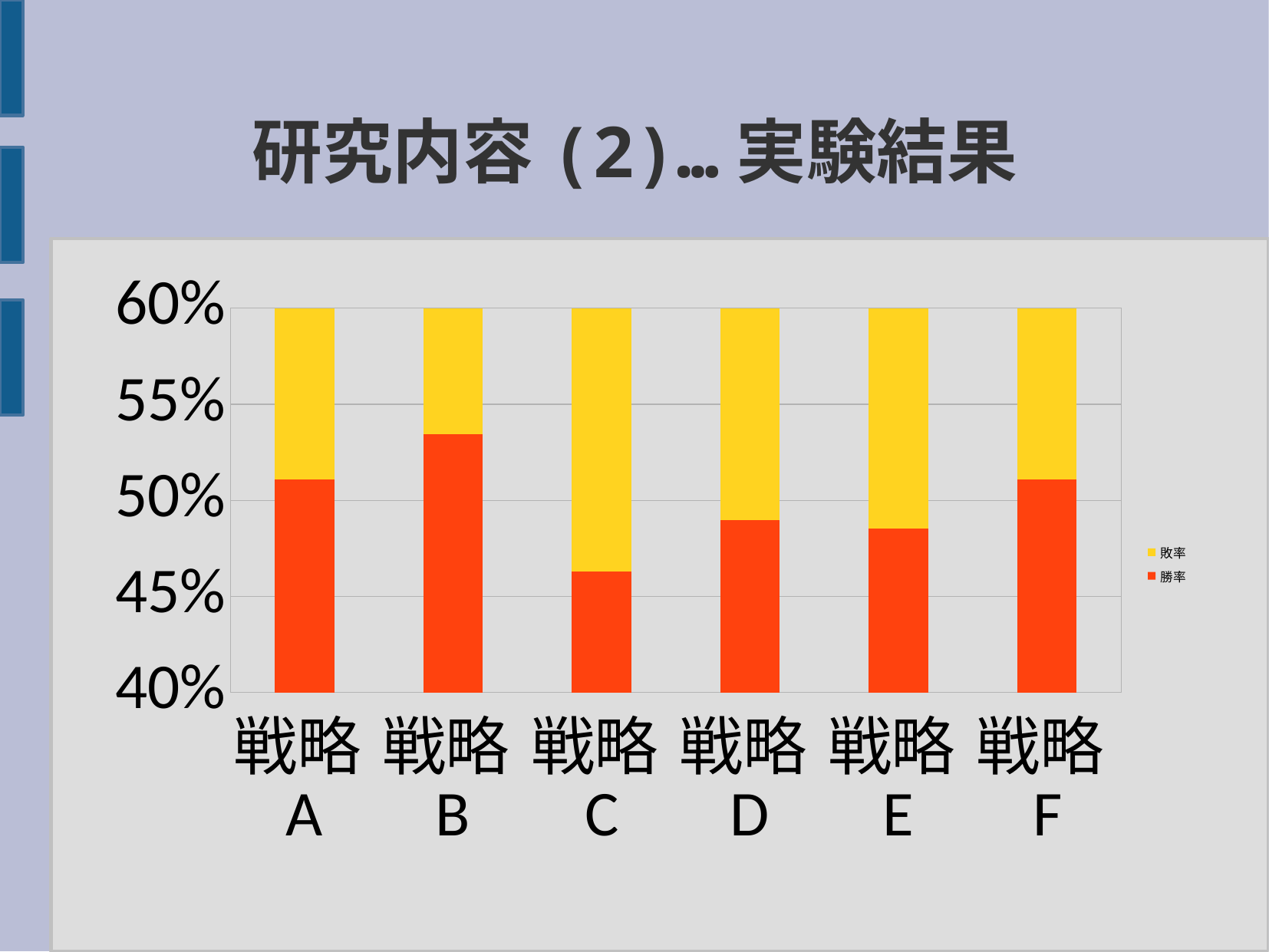
Is the 勝率 for 戦略C greater or less than 50%? less What kind of chart is shown on the slide? stacked bar chart How many strategies (categories) are shown on the x axis? 6 Which has the larger 勝率, 戦略B or 戦略C? 戦略B Which strategy has the lowest 勝率 (red segment)? 戦略C Which has the larger 勝率, 戦略A or 戦略E? 戦略A Is the 勝率 for 戦略B greater or less than 55%? less Is the 勝率 for 戦略D greater or less than 50%? less How many series does the legend list? 2 Which colour represents 敗率 in the legend? yellow Which strategy has the highest 勝率 (red segment)? 戦略B